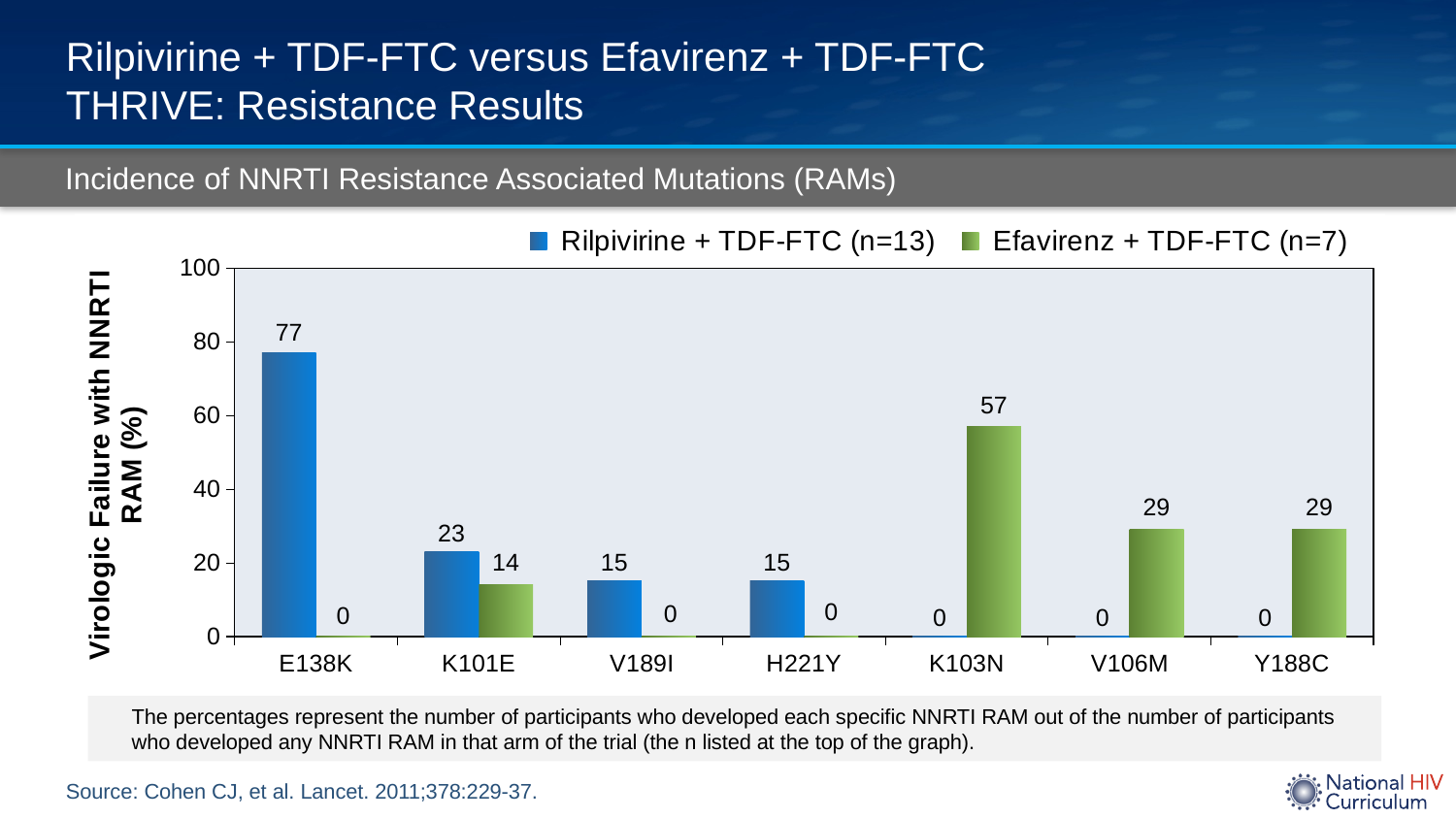
Which series has the larger value for V106M, Rilpivirine + TDF-FTC or Efavirenz + TDF-FTC? Efavirenz + TDF-FTC How many series does the legend list? 2 Is the value for E138K in the Rilpivirine + TDF-FTC series greater or less than 60? greater Which mutation has the highest value in the Efavirenz + TDF-FTC (n=7) series? K103N Which mutation has the highest value in the Rilpivirine + TDF-FTC (n=13) series? E138K What is the value for E138K in the Rilpivirine + TDF-FTC (n=13) series? 77 How many mutation categories are shown on the x axis? 7 What is the y-axis label of the chart? Virologic Failure with NNRTI RAM (%) What is the difference between the Rilpivirine + TDF-FTC and Efavirenz + TDF-FTC values for K101E? 9 What is the value for K101E in the Efavirenz + TDF-FTC (n=7) series? 14 What kind of chart is shown on the slide? Bar chart What is the value for K103N in the Efavirenz + TDF-FTC (n=7) series? 57